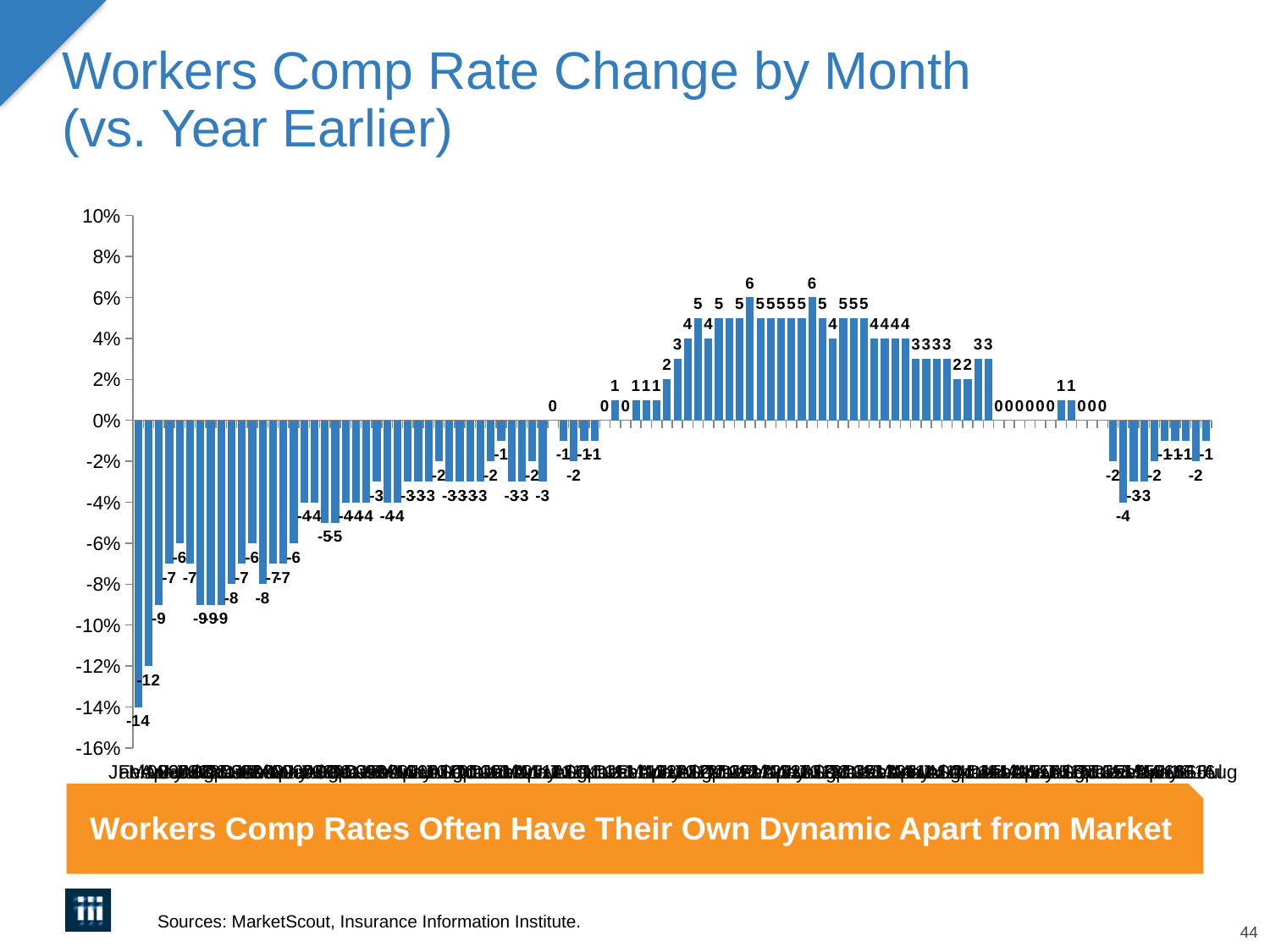
What is the highest value plotted in the chart? 6 What is the value of the rightmost bar in the chart? -1 What is the value of the second bar from the left in the chart? -12 Is the value of the leftmost bar greater or less than -10%? less Which is larger, the value of the leftmost bar or the value of the rightmost bar? the rightmost bar What is the difference between the leftmost bar (-14) and the second bar from the left (-12)? 2 What is the lowest value plotted in the chart? -14 What is the difference between the highest value (6) and the lowest value (-14) in the chart? 20 What is the title of the chart? Workers Comp Rate Change by Month (vs. Year Earlier) Starting from the leftmost bar, do the values rise or fall over the first several bars? rise What kind of chart is shown on the slide? bar chart What is the value of the leftmost bar in the chart? -14